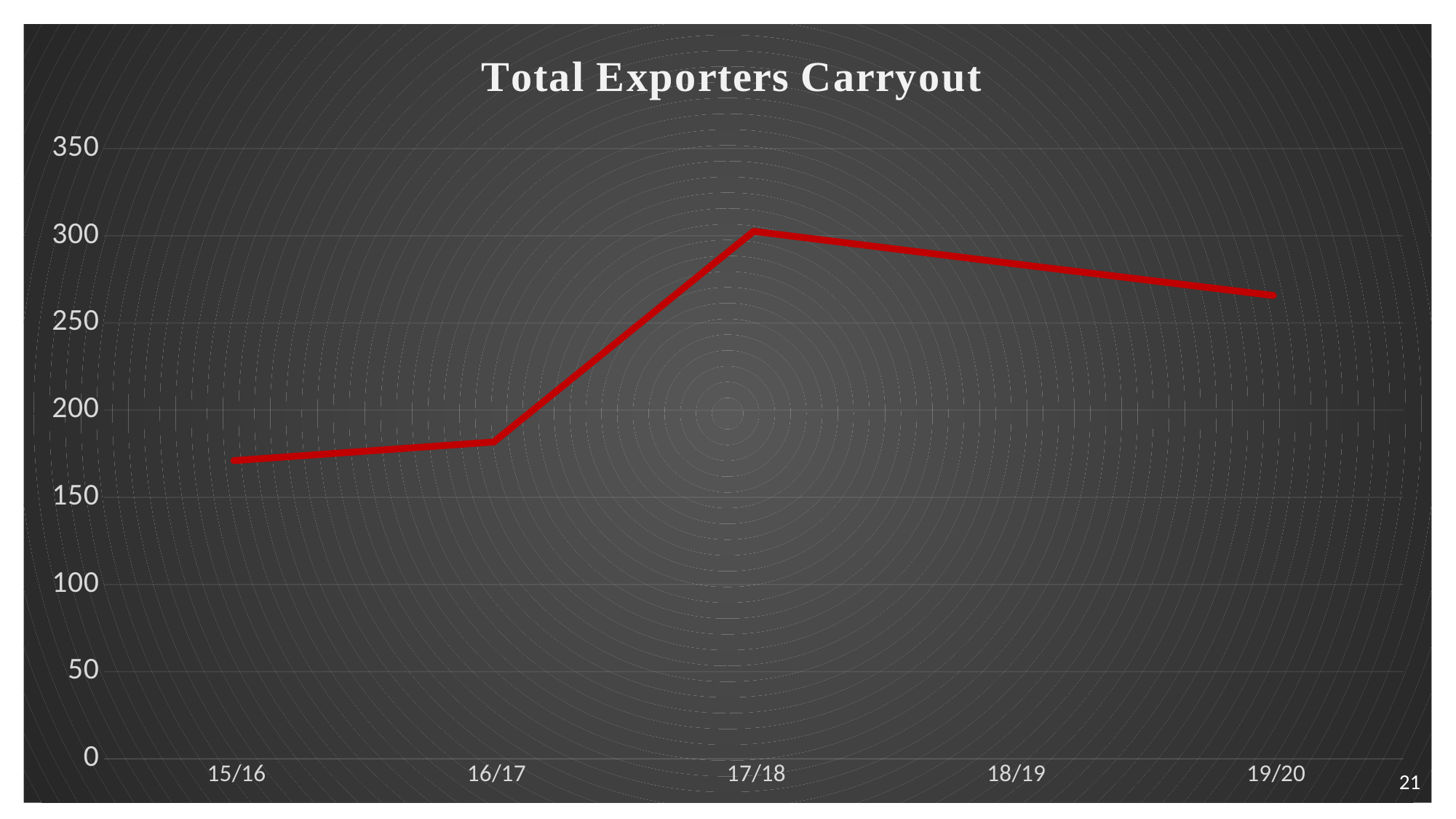
Is the value for 16/17 greater or less than 200? less Is the value for 19/20 greater or less than 300? less Which season has the lowest Total Exporters Carryout? 15/16 Is the value for 17/18 greater or less than 250? greater Which season has the highest Total Exporters Carryout? 17/18 What is the title of the chart? Total Exporters Carryout What kind of chart is shown on the slide? line chart Which is larger, the value for 17/18 or the value for 19/20? 17/18 How many seasons are plotted along the x axis? 5 Does the line rise or fall from 17/18 to 19/20? fall